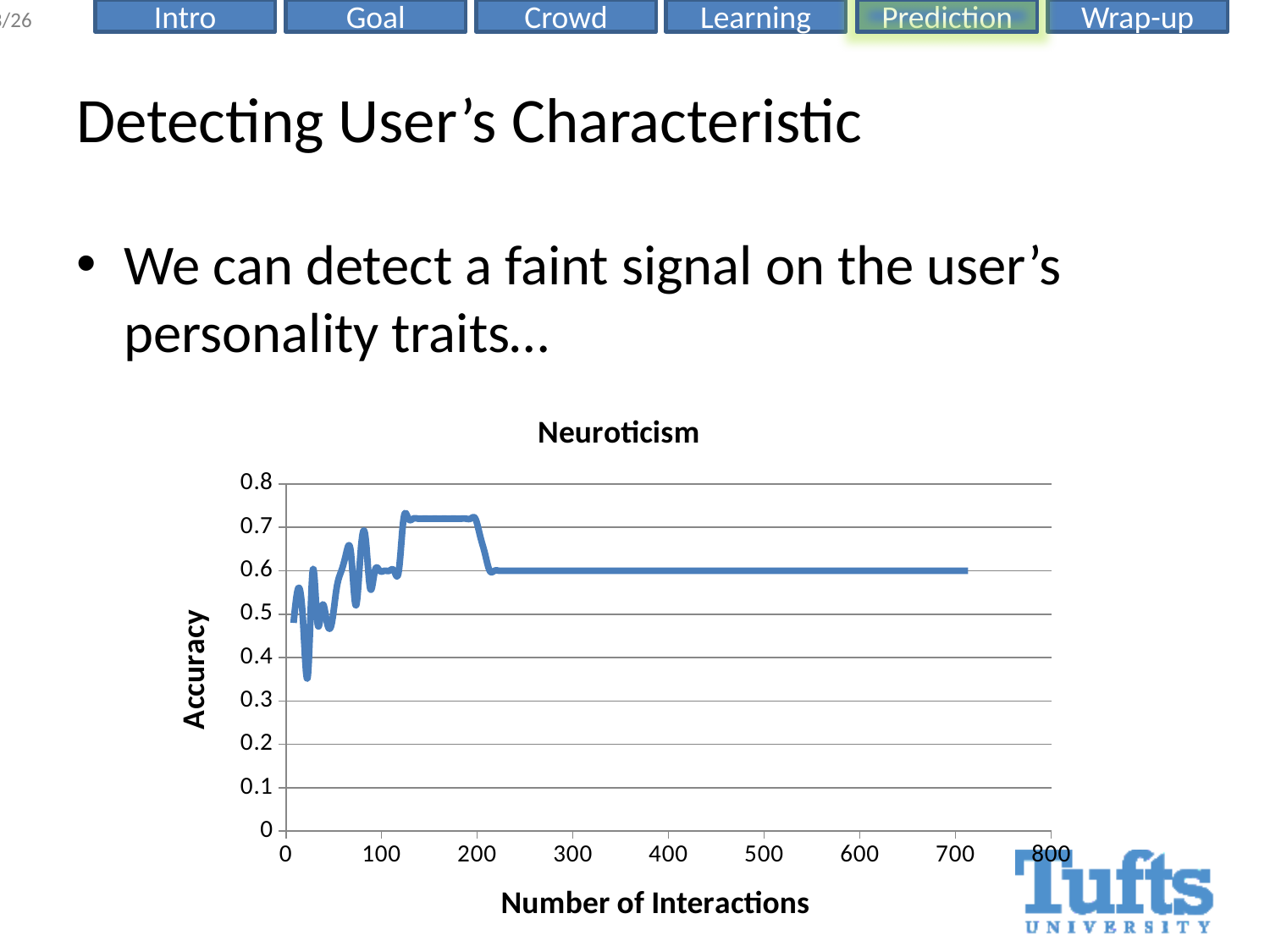
Is the accuracy at 400 interactions greater or less than 0.5? greater Is the accuracy at 600 interactions greater or less than 0.7? less What is the title of the chart? Neuroticism How many series are plotted in the chart? 1 Is the accuracy at 100 interactions greater or less than 0.5? greater What is the label of the y-axis of the chart? Accuracy What kind of chart is shown on the slide? line chart What is the highest value shown on the y-axis? 0.8 Does the line end at a higher or lower accuracy than it starts? higher